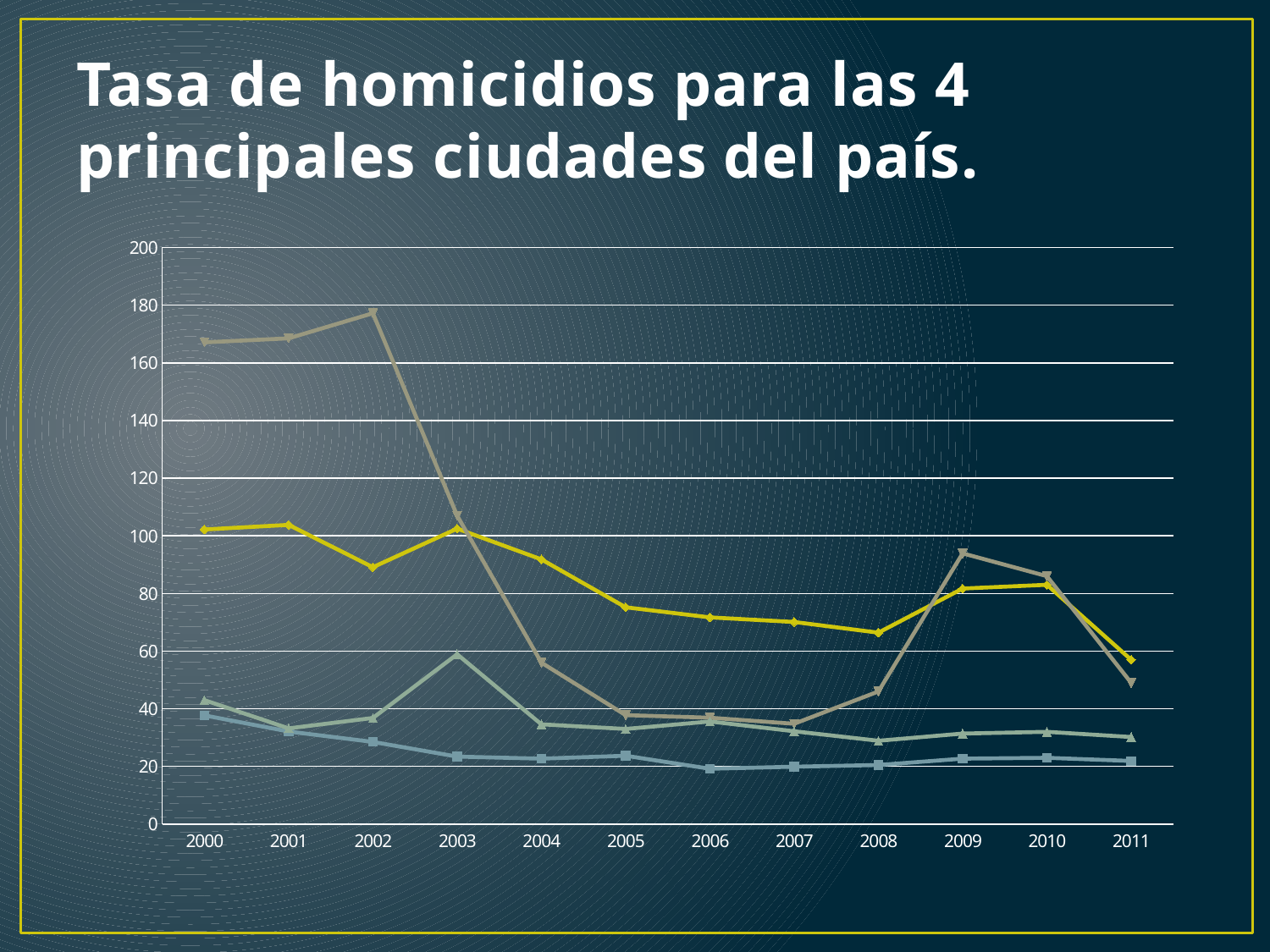
Does the yellow line rise or fall between 2000 and 2005? fall Is the value of the tan line with triangle markers in 2002 greater or less than 160? greater Is the value of the yellow line in 2005 greater or less than 60? greater Is the value of the tan line with triangle markers in 2004 greater or less than 80? less How many years are shown along the x axis of the chart? 12 What is the highest value shown on the y axis of the chart? 200 In which year does the tan line with triangle markers reach its highest value? 2002 What kind of chart is shown on the slide? line chart What is the title of the slide containing the chart? Tasa de homicidios para las 4 principales ciudades del país.